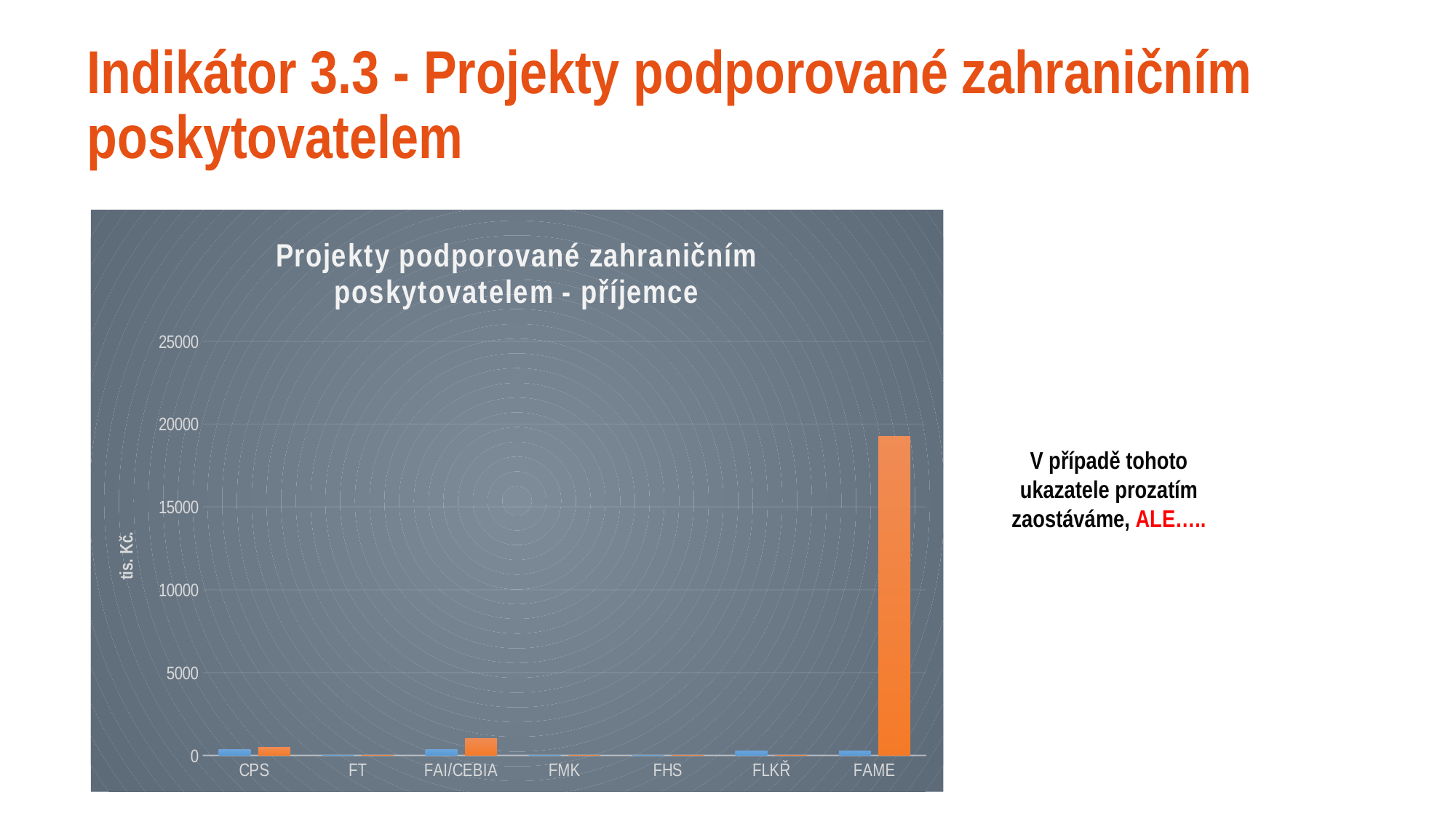
What is the label of the vertical axis of the chart? tis. Kč How many categories are shown on the x axis of the chart? 7 Is the value of the orange bar for FAME greater or less than 15000? greater Which has the larger orange bar, FAME or CPS? FAME What kind of chart is shown on the slide? bar chart Is the value of the orange bar for FAI/CEBIA greater or less than 5000? less Is the value of the orange bar for CPS greater or less than 5000? less Which has the larger orange bar, FAI/CEBIA or CPS? FAI/CEBIA What is the title of the chart? Projekty podporované zahraničním poskytovatelem - příjemce What is the highest value shown on the vertical axis of the chart? 25000 Which category has the tallest bar in the chart? FAME